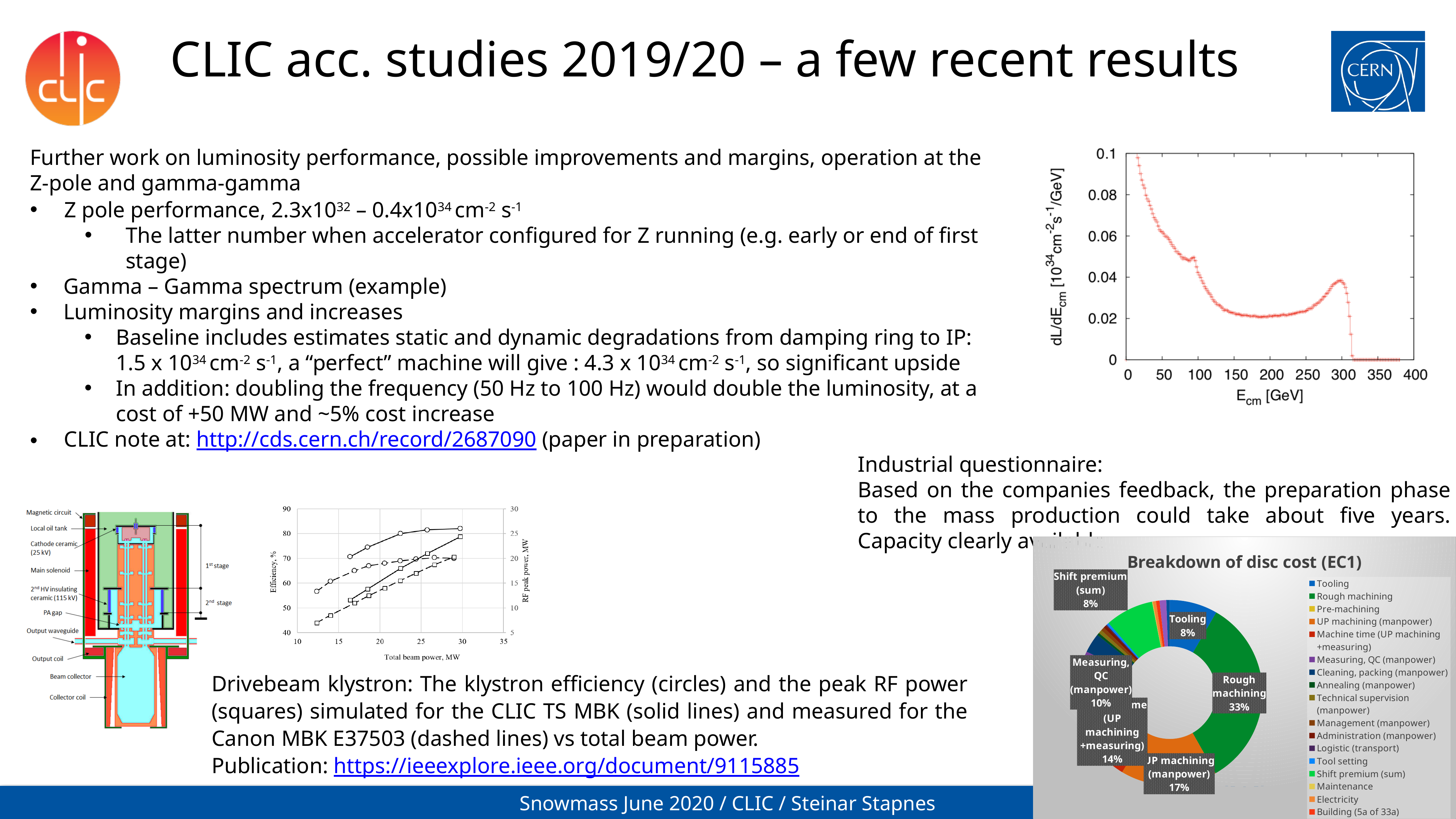
In the gamma-gamma spectrum chart at the top right, what is the label of the x axis? Ecm [GeV] In the 'Breakdown of disc cost (EC1)' chart, what share of the cost is UP machining (manpower)? 17% What kind of chart is the 'Breakdown of disc cost (EC1)' chart? Doughnut chart In the gamma-gamma spectrum chart at the top right, is the value at Ecm = 50 GeV greater or less than 0.04? greater In the drivebeam klystron chart, do the efficiency curves rise or fall as total beam power increases? rise In the 'Breakdown of disc cost (EC1)' chart, which labelled slice has the largest share? Rough machining In the 'Breakdown of disc cost (EC1)' chart, which is larger: the share for Measuring, QC (manpower) or the share for Shift premium (sum)? Measuring, QC (manpower) In the 'Breakdown of disc cost (EC1)' chart, what share of the cost is Rough machining? 33% In the 'Breakdown of disc cost (EC1)' chart, what is the difference in share between Rough machining and UP machining (manpower)? 16% How many entries does the legend of the 'Breakdown of disc cost (EC1)' chart list? 17 In the gamma-gamma spectrum chart at the top right, is the value at Ecm = 200 GeV greater or less than 0.04? less In the 'Breakdown of disc cost (EC1)' chart, what share is labelled for Tooling? 8%